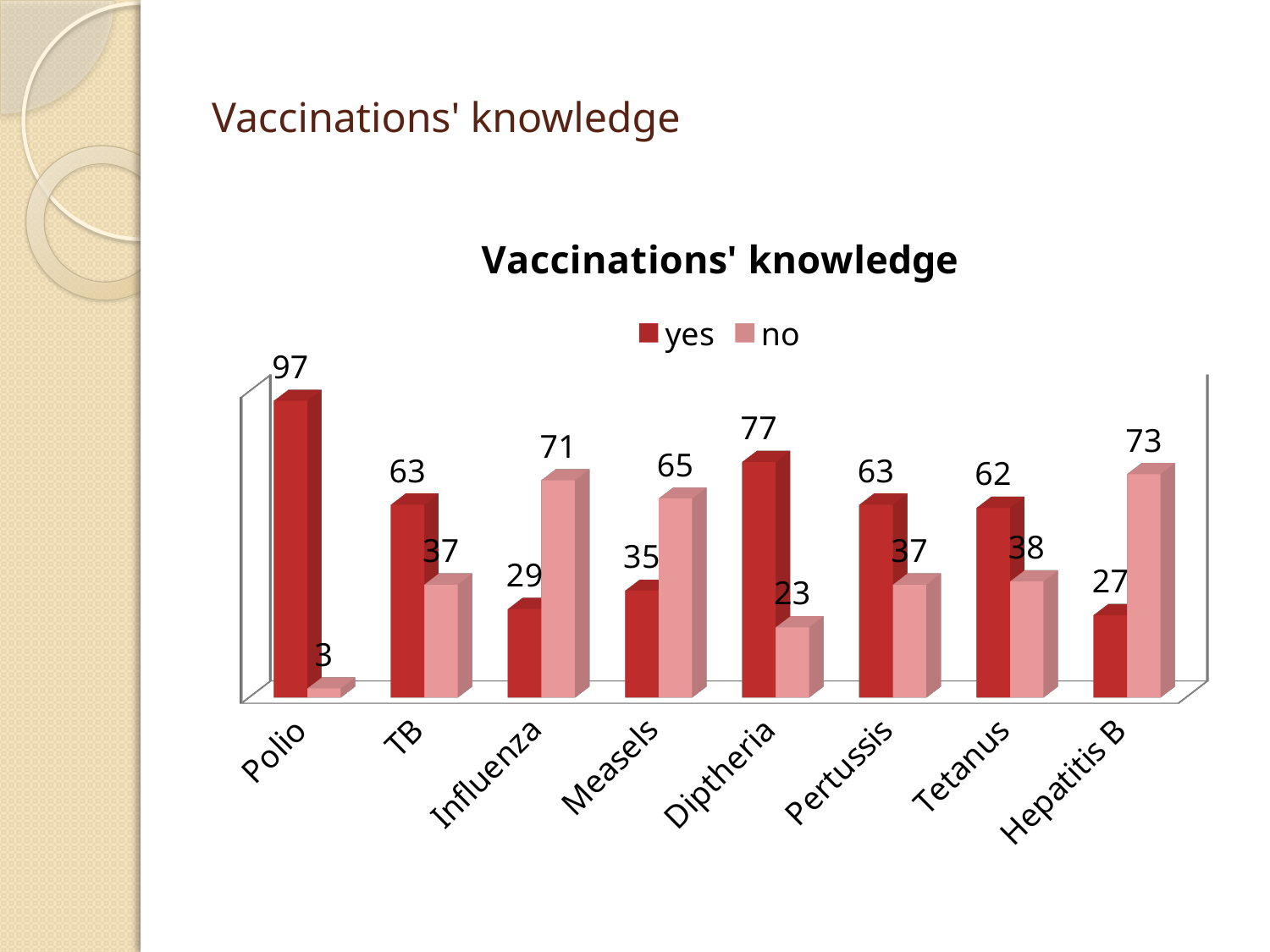
Which is larger for Measels, the 'yes' value or the 'no' value? no What kind of chart is shown? bar chart What is the title of the chart? Vaccinations' knowledge What is the 'no' value for Influenza? 71 How many categories are shown on the x axis? 8 What is the 'yes' value for Diptheria? 77 Which category has the highest 'yes' value? Polio What is the difference between the 'yes' and 'no' values for Hepatitis B? 46 What is the 'no' value for Tetanus? 38 Which category has the lowest 'no' value? Polio How many series does the legend list? 2 What is the 'yes' value for Polio? 97